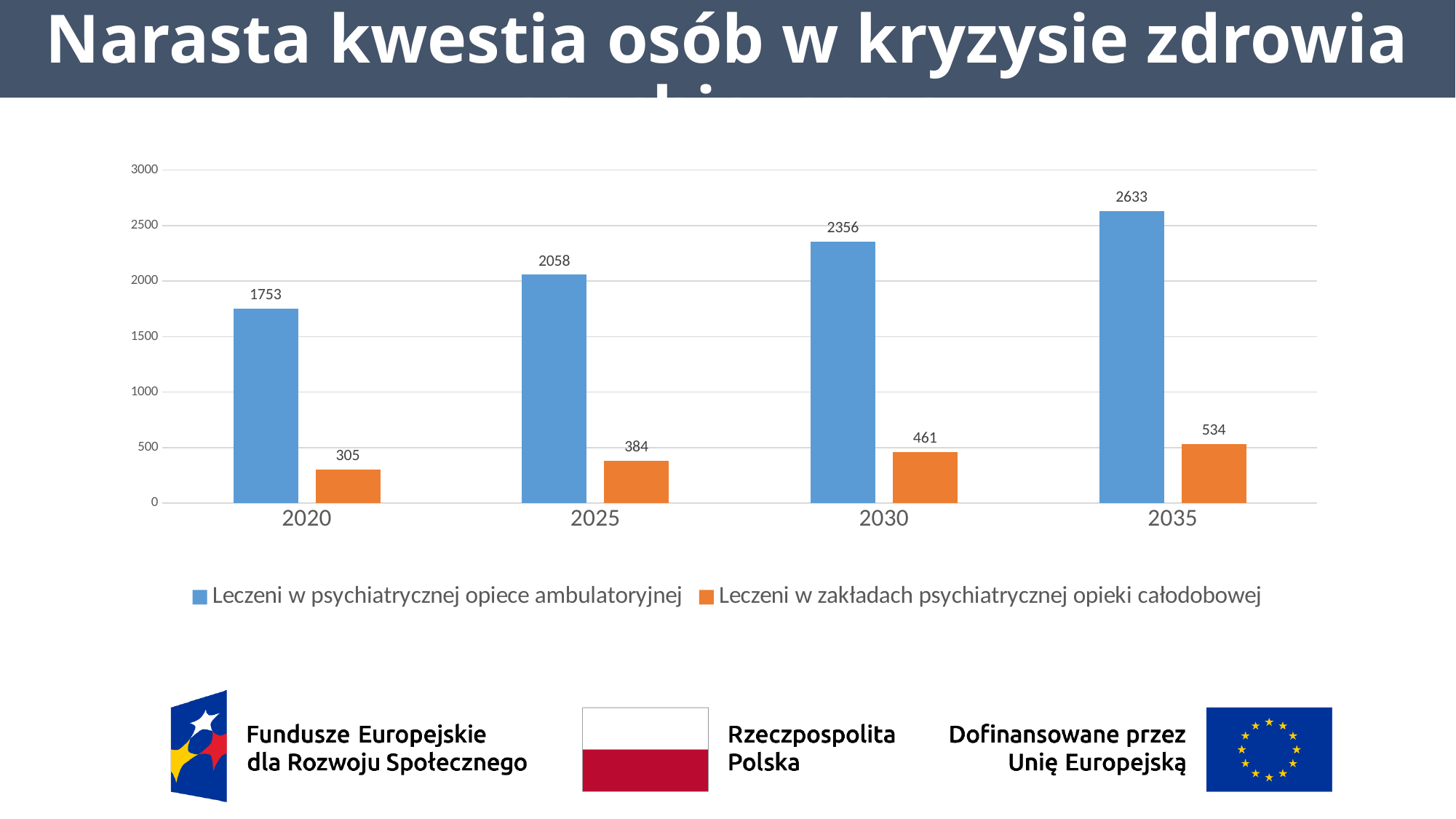
Do the values for 'Leczeni w zakładach psychiatrycznej opieki całodobowej' rise or fall from 2020 to 2035? Rise How many years are shown on the x axis? 4 Which is larger in 2030: 'Leczeni w psychiatrycznej opiece ambulatoryjnej' or 'Leczeni w zakładach psychiatrycznej opieki całodobowej'? Leczeni w psychiatrycznej opiece ambulatoryjnej In which year is the value for 'Leczeni w zakładach psychiatrycznej opieki całodobowej' lowest? 2020 How many series does the legend list? 2 What is the difference between the 'Leczeni w psychiatrycznej opiece ambulatoryjnej' values for 2035 and 2020? 880 In which year is the value for 'Leczeni w psychiatrycznej opiece ambulatoryjnej' highest? 2035 What is the difference between the two series' values in 2025? 1674 What is the value for 'Leczeni w zakładach psychiatrycznej opieki całodobowej' in 2035? 534 What is the value for 'Leczeni w psychiatrycznej opiece ambulatoryjnej' in 2030? 2356 What kind of chart is shown on the slide? Bar chart What is the value for 'Leczeni w psychiatrycznej opiece ambulatoryjnej' in 2020? 1753